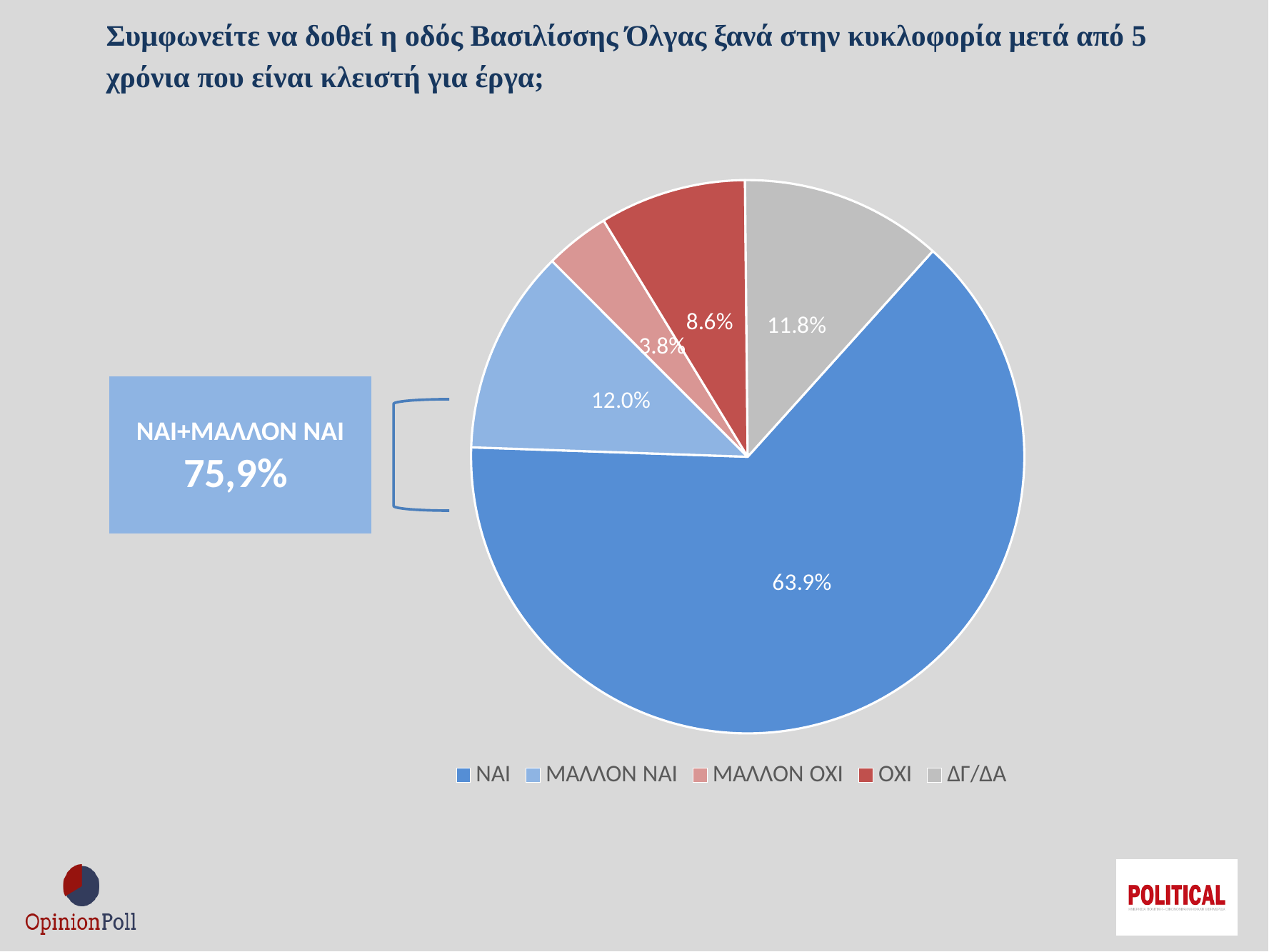
Which category has the smallest slice? ΜΑΛΛΟΝ ΟΧΙ Which is larger, the value for ΟΧΙ or the value for ΔΓ/ΔΑ? ΔΓ/ΔΑ What combined value is shown in the box for ΝΑΙ+ΜΑΛΛΟΝ ΝΑΙ? 75,9% What is the value for ΜΑΛΛΟΝ ΟΧΙ? 3.8% What kind of chart is shown on the slide? pie chart What is the value for ΟΧΙ? 8.6% How many categories does the legend list? 5 What is the difference between the values for ΝΑΙ and ΜΑΛΛΟΝ ΝΑΙ? 51.9% What is the value for ΜΑΛΛΟΝ ΝΑΙ? 12.0% What is the value for ΝΑΙ? 63.9% Which category has the largest slice? ΝΑΙ What is the value for ΔΓ/ΔΑ? 11.8%